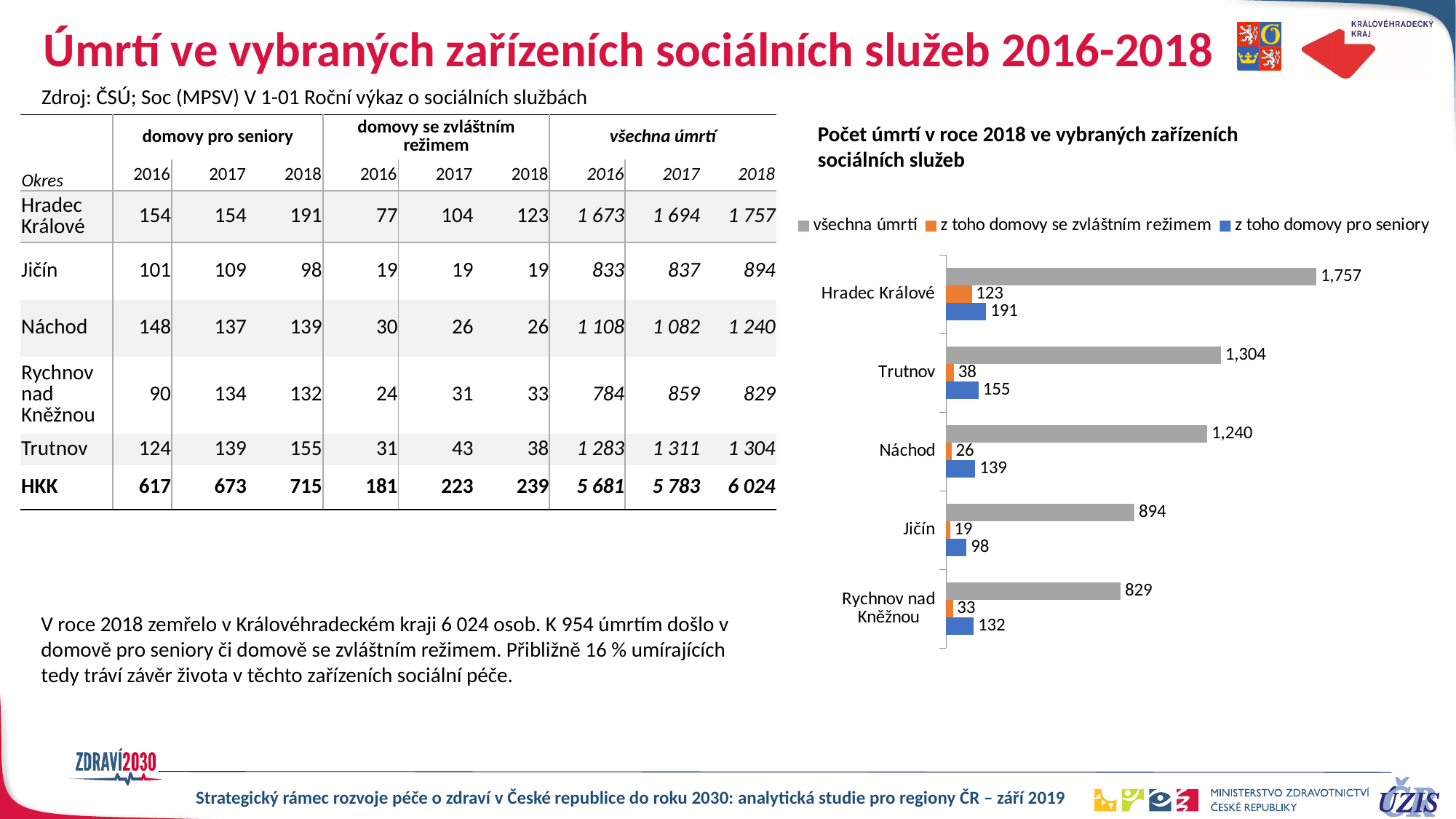
In the chart, what is the value of 'z toho domovy pro seniory' for Trutnov? 155 Which district has the lowest value of 'z toho domovy se zvláštním režimem' in the chart? Jičín How many series does the chart legend list? 3 What is the title of the chart on the slide? Počet úmrtí v roce 2018 ve vybraných zařízeních sociálních služeb In the chart, which is larger: 'z toho domovy pro seniory' for Náchod or for Jičín? Náchod In the chart, what is the difference between 'všechna úmrtí' for Trutnov and for Náchod? 64 How many districts (categories) are shown in the chart? 5 In the chart, what is the value of 'z toho domovy se zvláštním režimem' for Jičín? 19 In the chart, what is the value of 'z toho domovy pro seniory' for Rychnov nad Kněžnou? 132 What type of chart is shown on the slide? bar chart Which district has the highest value of 'všechna úmrtí' in the chart? Hradec Králové In the chart, what is the value of 'všechna úmrtí' for Hradec Králové? 1,757